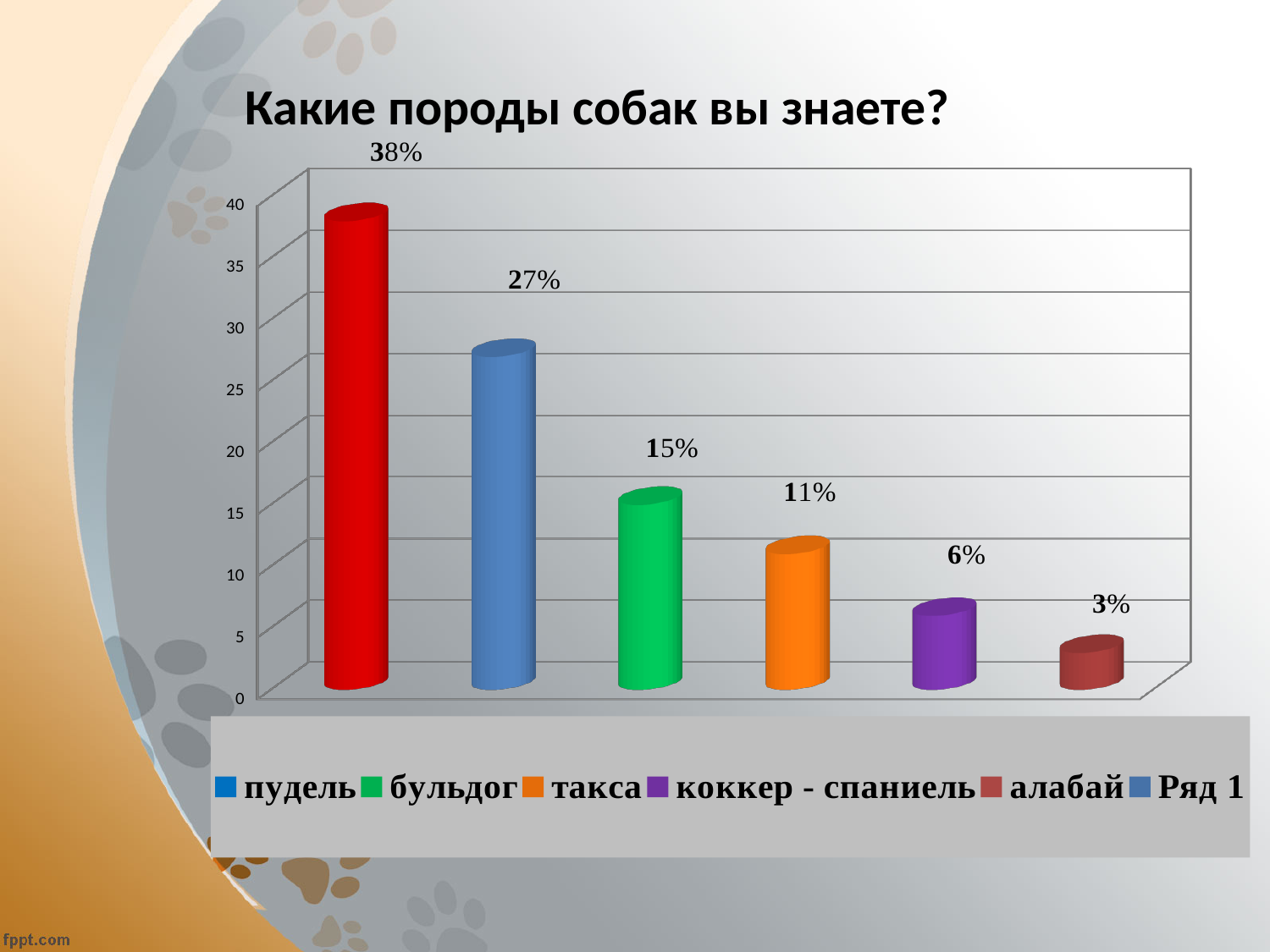
Which is larger, the value of the green bar or the value of the orange bar? the green bar What value is labelled on the shortest bar? 3% How many bars are plotted in the chart? 6 How many entries does the legend list? 6 What value is labelled on the tallest (red) bar? 38% What value is labelled on the purple bar (коккер - спаниель)? 6% Do the bar values rise or fall from left to right across the chart? fall What is the difference between the values of the red bar (38%) and the blue bar (27%)? 11% What value is labelled on the green bar (бульдог)? 15% What type of chart is shown on the slide? bar chart What is the title of the chart? Какие породы собак вы знаете? What value is labelled on the orange bar (такса)? 11%